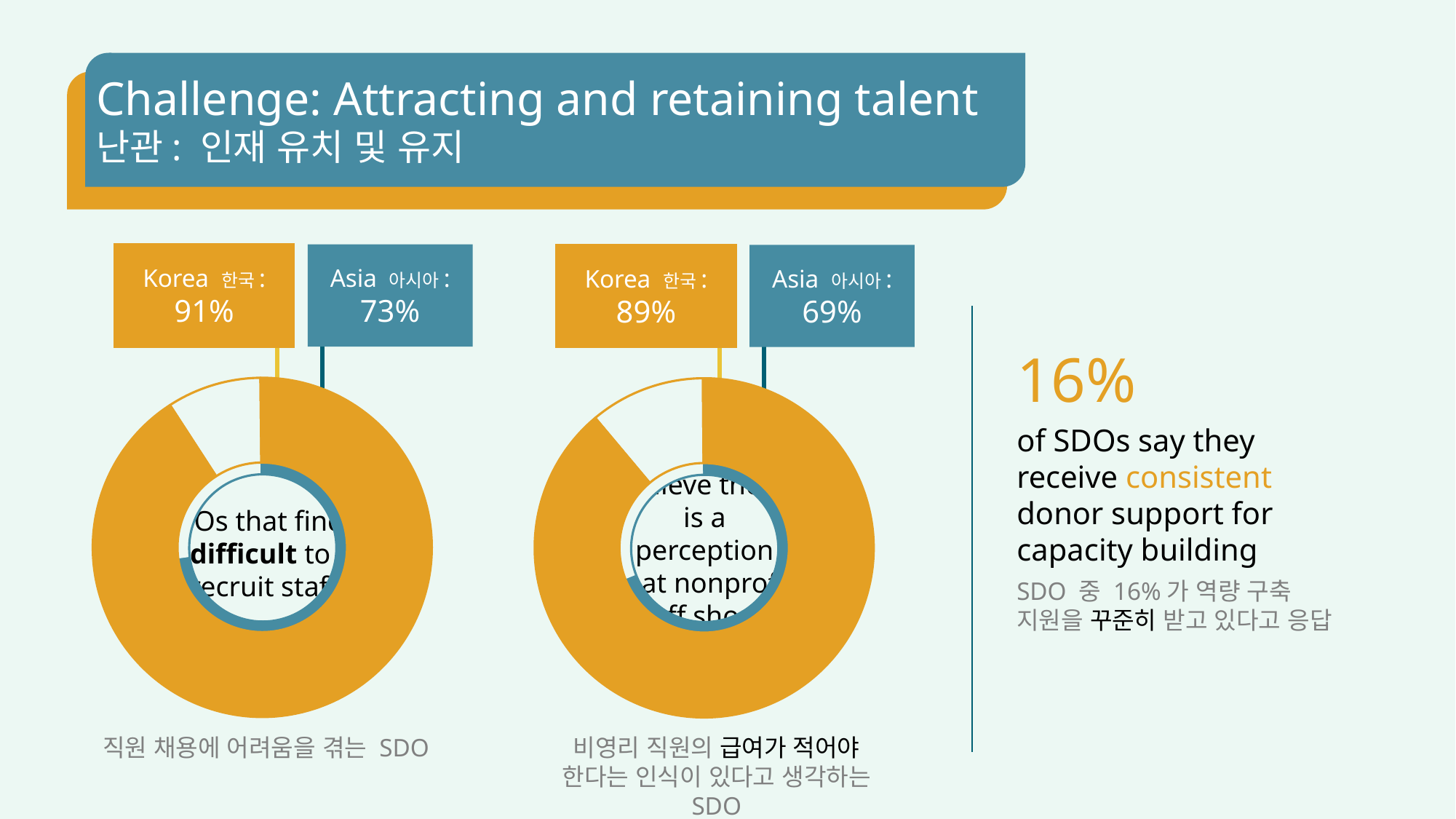
On the right donut chart, what is the value for Asia? 69% What kind of chart is used on the left of the slide? Donut (pie) chart On the right donut chart, what is the value for Korea? 89% On the left donut chart, what is the value for Korea? 91% On the right donut chart, which is larger, the value for Korea or the value for Asia? Korea On the left donut chart, what is the value for Asia? 73% On the left donut chart, which is larger, the value for Korea or the value for Asia? Korea On the right donut chart, what is the difference between the Korea value and the Asia value? 20 percentage points On the right donut chart, which colour represents Asia? Blue On the left donut chart, what is the difference between the Korea value and the Asia value? 18 percentage points How many donut charts are shown on the slide? 2 On the left donut chart, which colour represents Korea? Orange